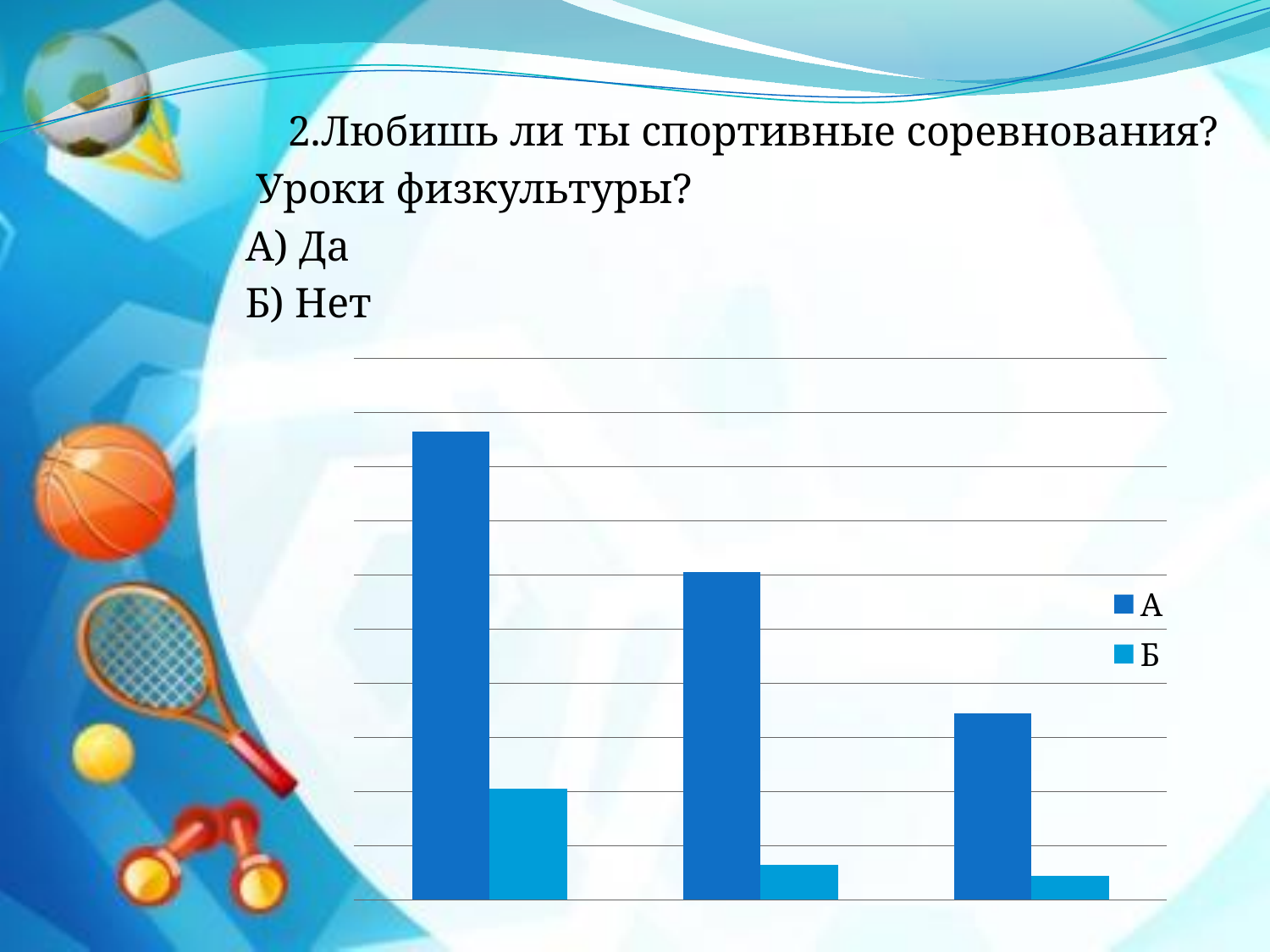
How many series does the legend list? 2 In the middle group of bars, which series has the larger value, А or Б? А In the leftmost group of bars, which series has the larger value, А or Б? А What kind of chart is shown on the slide? bar chart Which group of bars (leftmost, middle or rightmost) has the highest value for series А? leftmost Do the values of series А rise or fall from left to right across the groups? fall Do the values of series Б rise or fall from left to right across the groups? fall How many bars in total are plotted in the chart? 6 How many groups of bars are plotted in the chart? 3 Which group of bars (leftmost, middle or rightmost) has the lowest value for series Б? rightmost In the rightmost group of bars, which series has the larger value, А or Б? А What are the series names listed in the legend? А and Б